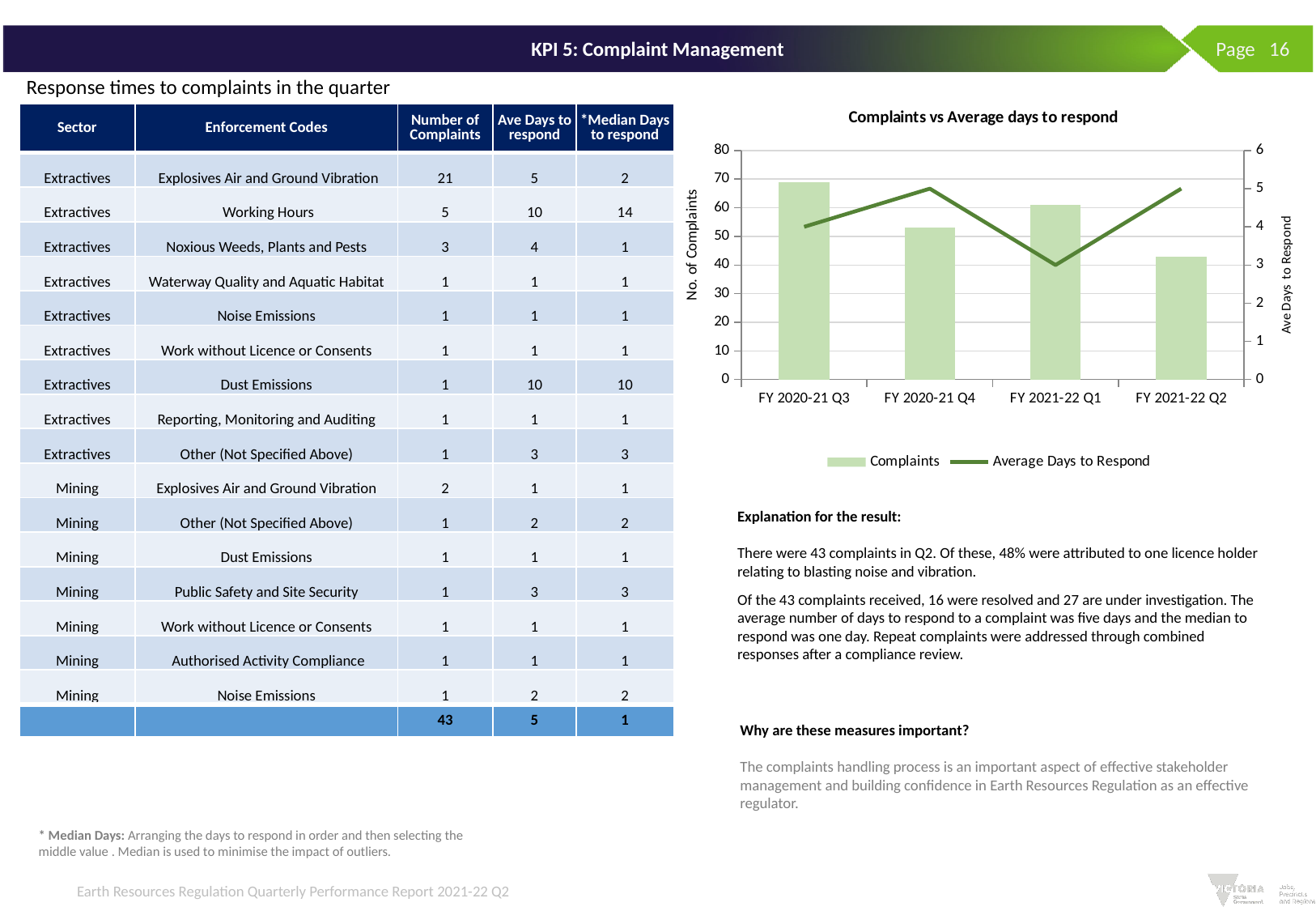
In the 'Complaints vs Average days to respond' chart, which quarter has the highest number of complaints? FY 2020-21 Q3 How many series does the legend of the 'Complaints vs Average days to respond' chart list? 2 In the 'Complaints vs Average days to respond' chart, is the number of complaints for FY 2021-22 Q2 greater or less than 50? less In the 'Complaints vs Average days to respond' chart, which quarter has more complaints, FY 2020-21 Q4 or FY 2021-22 Q1? FY 2021-22 Q1 In the 'Complaints vs Average days to respond' chart, is the number of complaints for FY 2020-21 Q4 greater or less than 60? less How many quarters are shown on the x axis of the 'Complaints vs Average days to respond' chart? 4 What kind of chart is 'Complaints vs Average days to respond'? Combined bar and line chart In the 'Complaints vs Average days to respond' chart, is the number of complaints for FY 2020-21 Q3 greater or less than 60? greater What is the label of the right-hand vertical axis in the 'Complaints vs Average days to respond' chart? Ave Days to Respond In the 'Complaints vs Average days to respond' chart, which quarter has the lowest average days to respond? FY 2021-22 Q1 In the 'Complaints vs Average days to respond' chart, what is the average days to respond for FY 2021-22 Q1? 3 In the 'Complaints vs Average days to respond' chart, which quarter has the lowest number of complaints? FY 2021-22 Q2